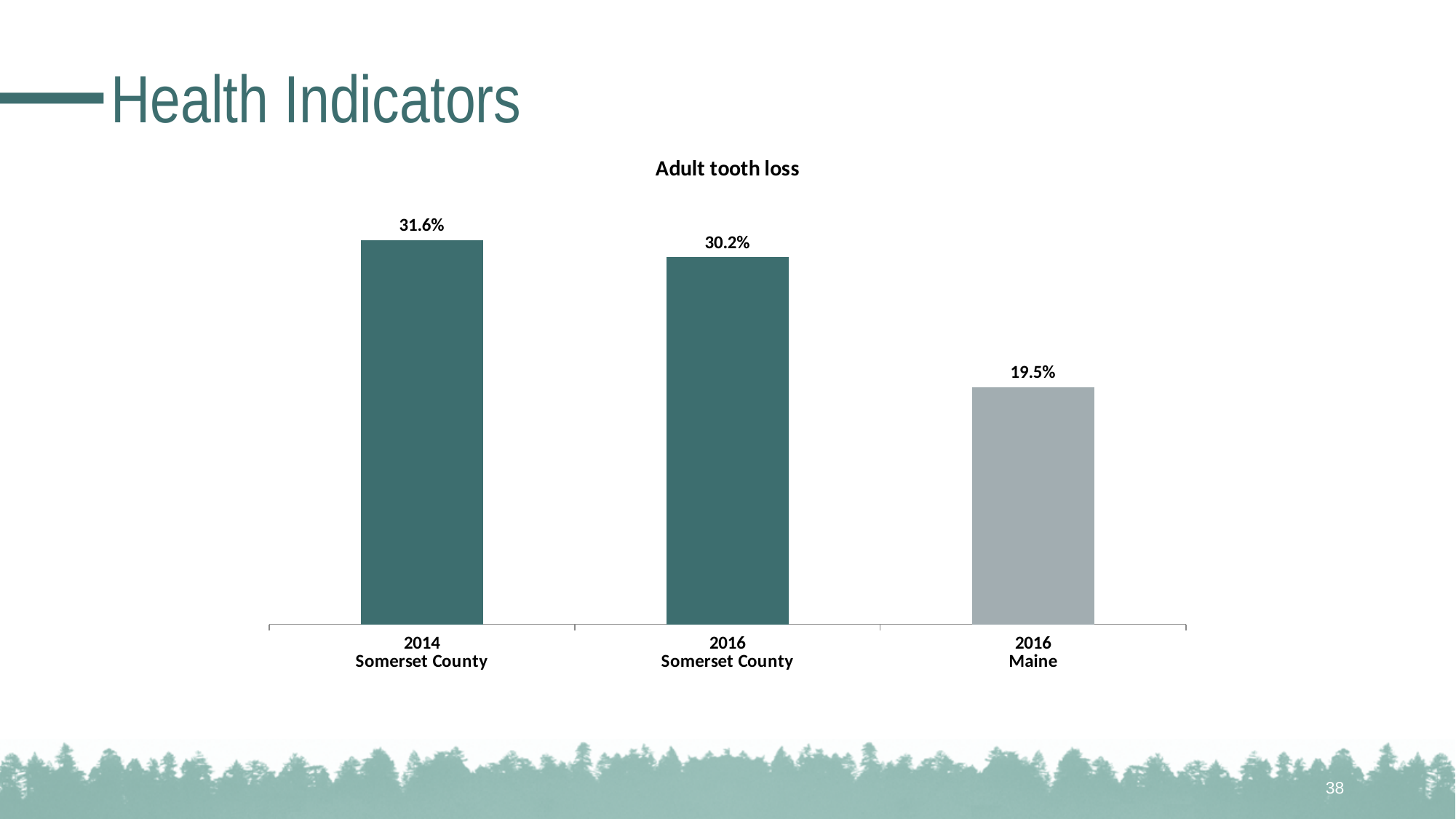
What is the adult tooth loss value for Maine in 2016? 19.5% Which category has the highest adult tooth loss value? 2014 Somerset County What is the title of the chart? Adult tooth loss Which category has the lowest adult tooth loss value? 2016 Maine How many bars are shown in the chart? 3 What is the difference between the 2014 and 2016 Somerset County values? 1.4% Which is larger, the 2016 Somerset County value or the 2016 Maine value? 2016 Somerset County What kind of chart is shown on the slide? Bar chart What is the difference between the 2016 Somerset County value and the 2016 Maine value? 10.7% Did the adult tooth loss value for Somerset County rise or fall from 2014 to 2016? Fall What is the adult tooth loss value for Somerset County in 2016? 30.2% What is the adult tooth loss value for Somerset County in 2014? 31.6%